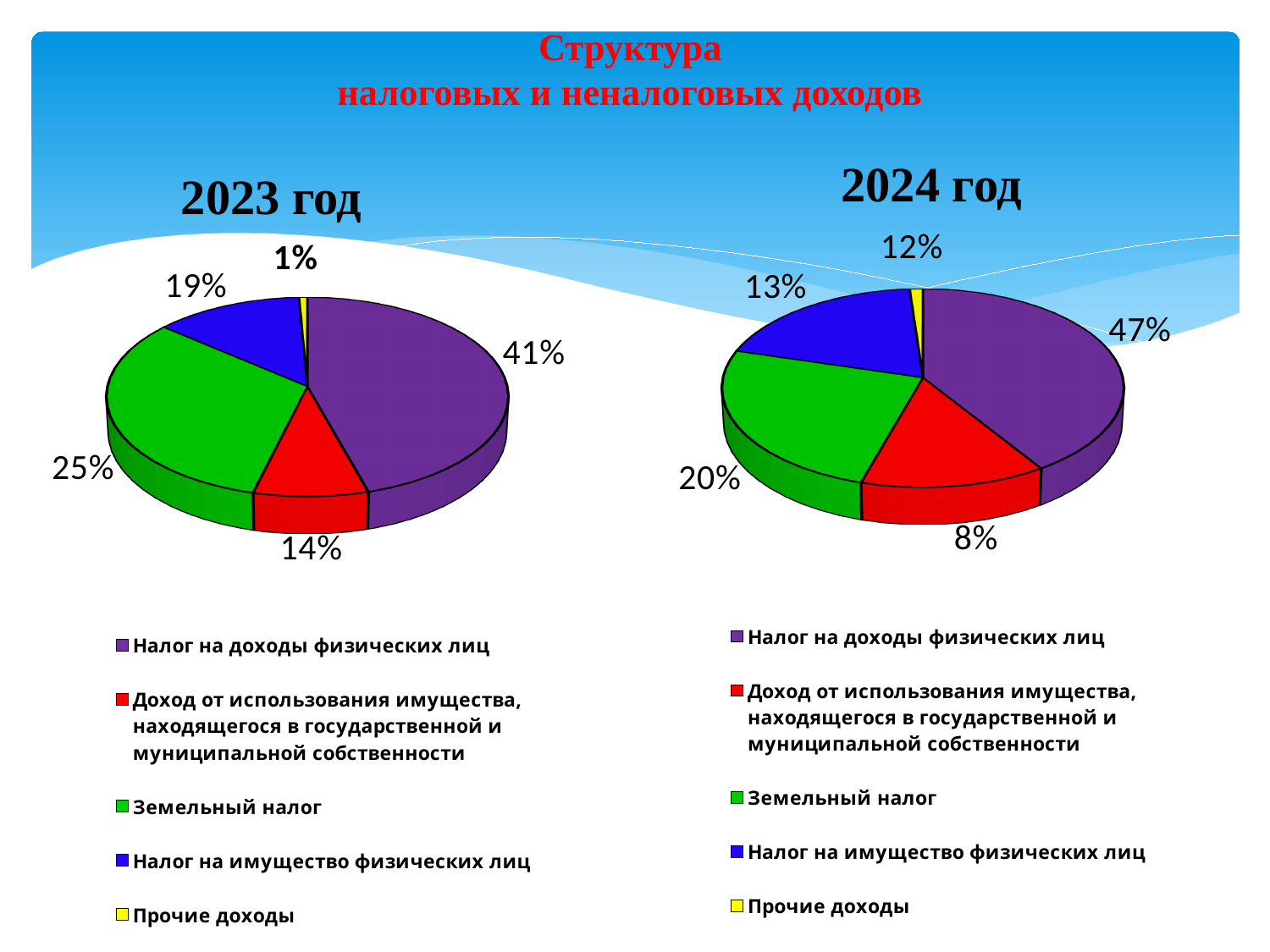
In the 2024 год pie chart, which category has the largest share? Налог на доходы физических лиц What is the difference between the share of Налог на доходы физических лиц in the 2024 год chart and in the 2023 год chart? 6% In the 2023 год pie chart, which category has the smallest share? Прочие доходы Which is larger: the share of Земельный налог in the 2023 год chart or in the 2024 год chart? 2023 год In the 2023 год pie chart, what share is Земельный налог? 25% In the 2023 год pie chart, what share is Прочие доходы? 1% In the 2023 год pie chart, what share is Налог на доходы физических лиц? 41% In the 2023 год pie chart, which category has the largest share? Налог на доходы физических лиц In the 2024 год pie chart, what share is Доход от использования имущества, находящегося в государственной и муниципальной собственности? 8% How many categories does the legend of the 2023 год chart list? 5 In the 2024 год pie chart, what share is Налог на доходы физических лиц? 47% In the 2024 год pie chart, what share is Налог на имущество физических лиц? 13%